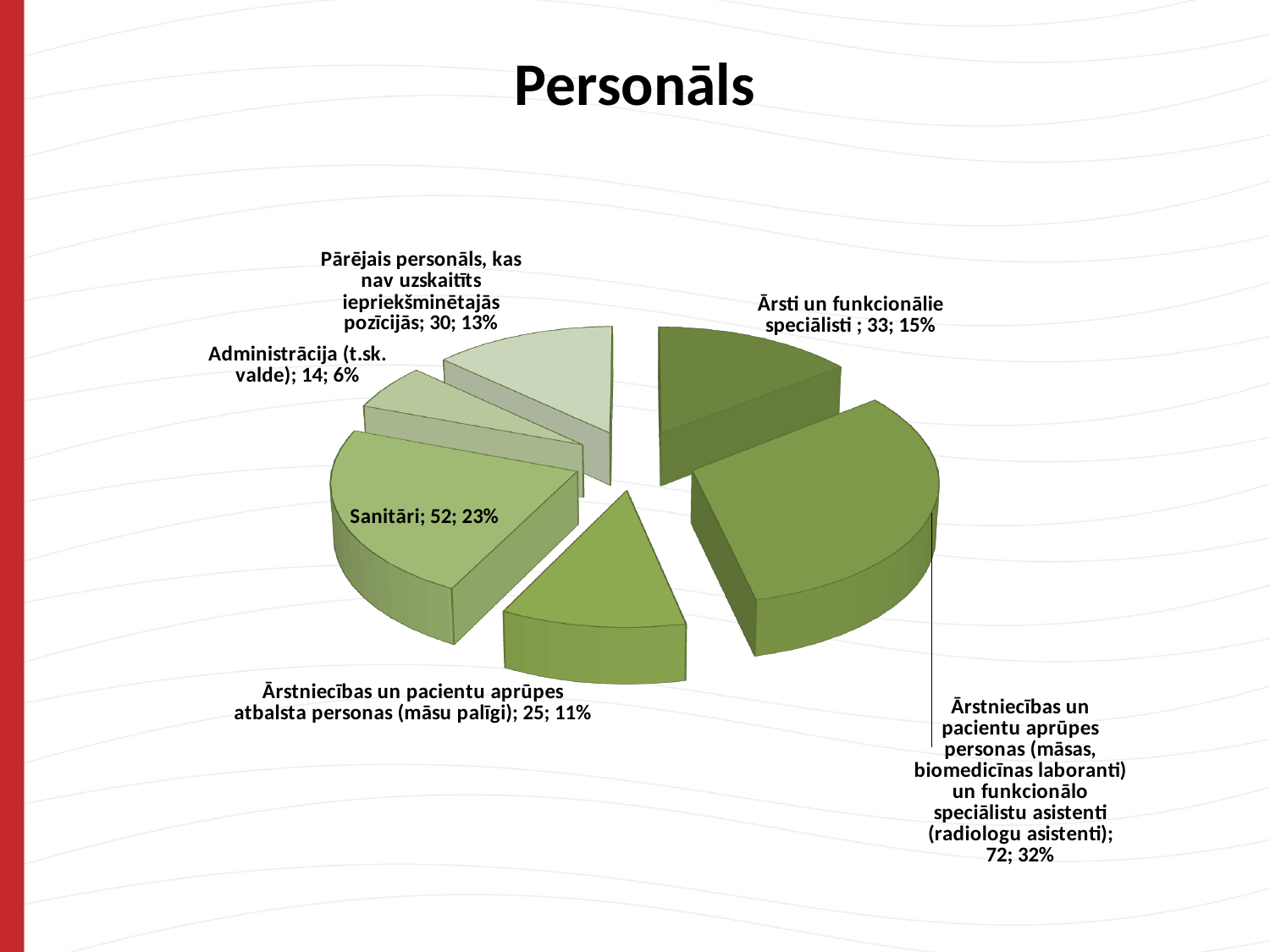
What is the difference between the value for Sanitāri and the value for Pārējais personāls, kas nav uzskaitīts iepriekšminētajās pozīcijās? 22 How many slices does the pie chart have? 6 What is the value for Administrācija (t.sk. valde)? 14 What percentage share does Ārstniecības un pacientu aprūpes atbalsta personas (māsu palīgi) have? 11% What percentage share does Sanitāri have? 23% What is the value for Sanitāri? 52 What type of chart is shown on the slide? Pie chart Which category has the smallest slice? Administrācija (t.sk. valde) What is the title of the chart? Personāls Which is larger, the value for Ārsti un funkcionālie speciālisti or the value for Ārstniecības un pacientu aprūpes atbalsta personas (māsu palīgi)? Ārsti un funkcionālie speciālisti What is the value for Ārsti un funkcionālie speciālisti? 33 Which category has the largest slice? Ārstniecības un pacientu aprūpes personas (māsas, biomedicīnas laboranti) un funkcionālo speciālistu asistenti (radiologu asistenti)